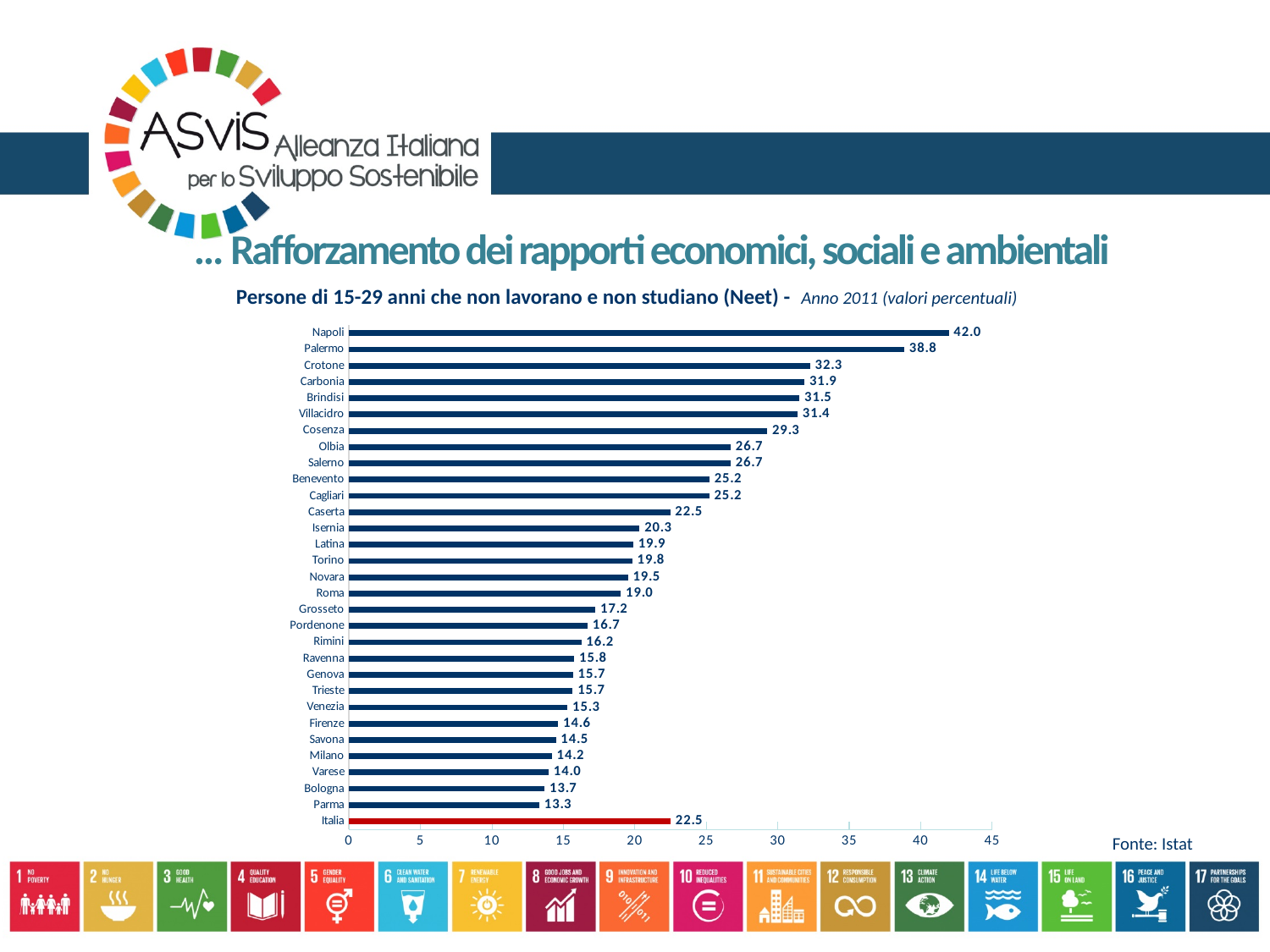
Which category has the lowest value? Parma What is the value for Milano? 14.2 Which bar is shown in a different colour (red) from the others? Italia What kind of chart is shown on the slide? bar chart What is the difference between the values for Napoli and Palermo? 3.2 What is the difference between the values for Roma and Italia? 3.5 How many categories are shown on the chart? 31 Which category has the highest value? Napoli What is the value for Italia? 22.5 What is the value for Napoli? 42.0 Which is larger, the value for Cosenza or the value for Olbia? Cosenza Is the value for Crotone greater or less than 30? greater